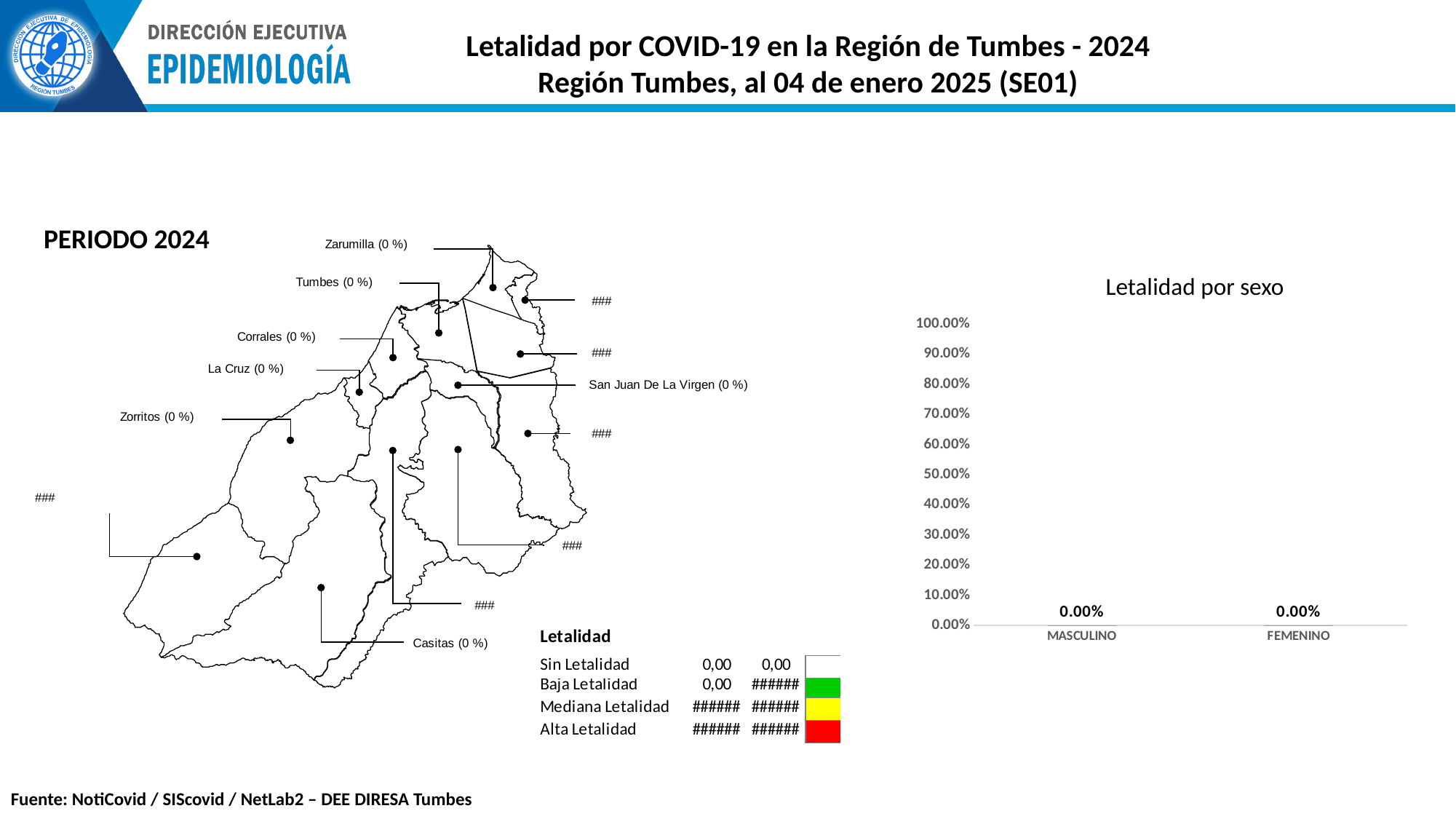
In the 'Letalidad por sexo' chart, what is the difference between the MASCULINO and FEMENINO values? 0.00% In the 'Letalidad por sexo' chart, what is the value for FEMENINO? 0.00% On the map, what lethality percentage is shown for San Juan De La Virgen? 0 % What kind of chart is 'Letalidad por sexo'? bar chart What is the title of the chart on the right side of the slide? Letalidad por sexo On the map, what lethality percentage is shown for Casitas? 0 % In the 'Letalidad por sexo' chart, is the value for FEMENINO greater or less than 50.00%? less What is the highest value shown on the y axis of the 'Letalidad por sexo' chart? 100.00% In the 'Letalidad por sexo' chart, do the values rise, fall or stay the same from MASCULINO to FEMENINO? stay the same In the 'Letalidad por sexo' chart, is the value for MASCULINO greater or less than 10.00%? less How many categories are shown on the x axis of the 'Letalidad por sexo' chart? 2 In the 'Letalidad por sexo' chart, what is the value for MASCULINO? 0.00%